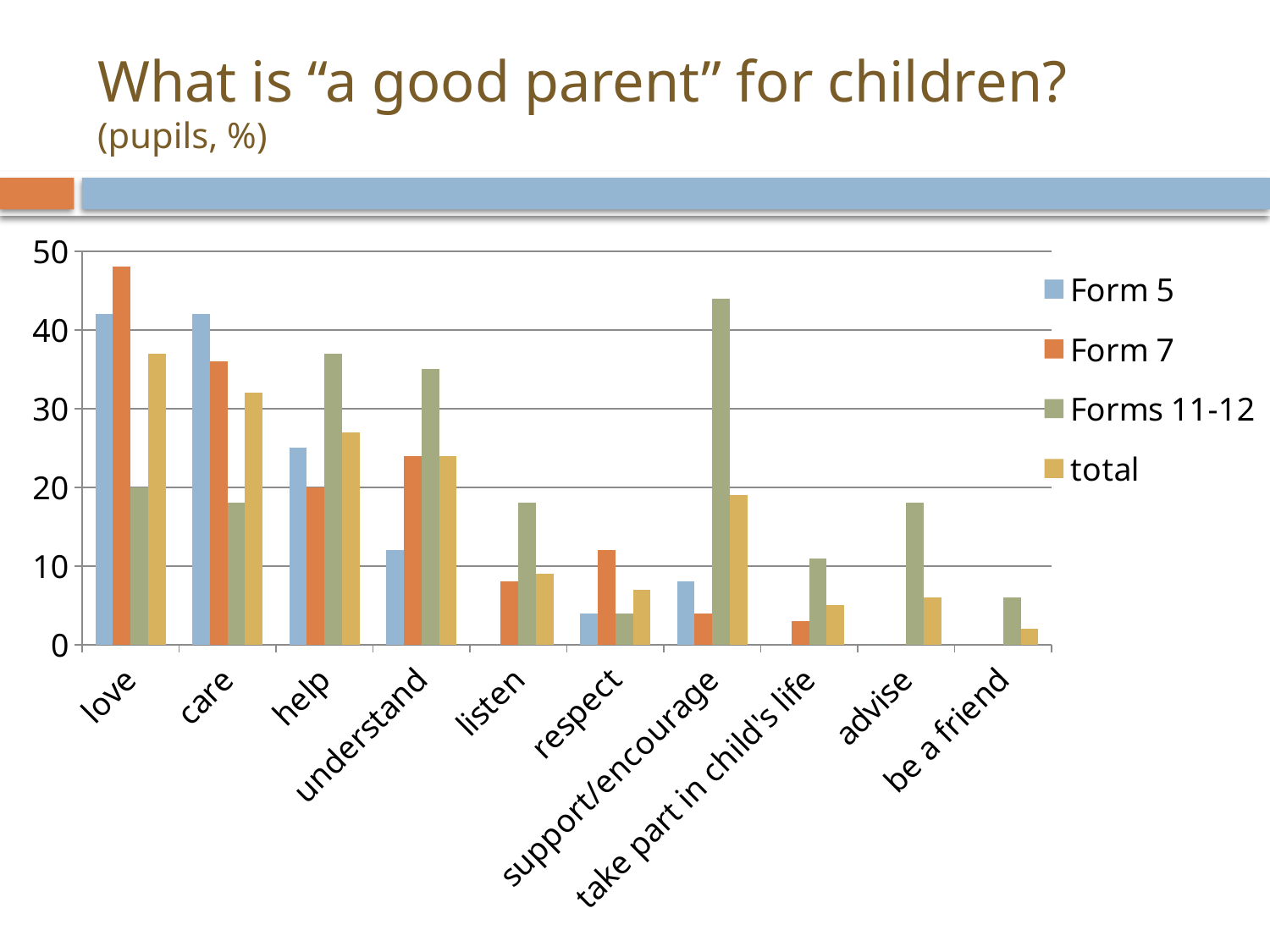
How many categories are shown on the x axis? 10 Which category has the highest Forms 11-12 value? support/encourage Which category has the highest Form 7 value? love For help, which is larger: the Form 5 value or the Forms 11-12 value? Forms 11-12 How many series does the legend list? 4 What kind of chart is shown on the slide? bar chart What are the series names listed in the legend? Form 5, Form 7, Forms 11-12, total Is the total value for support/encourage greater or less than 10? greater Is the Form 7 value for love greater or less than 40? greater Is the Forms 11-12 value for understand greater or less than 30? greater Which category has the lowest total value? be a friend For love, which is larger: the Form 5 value or the Form 7 value? Form 7